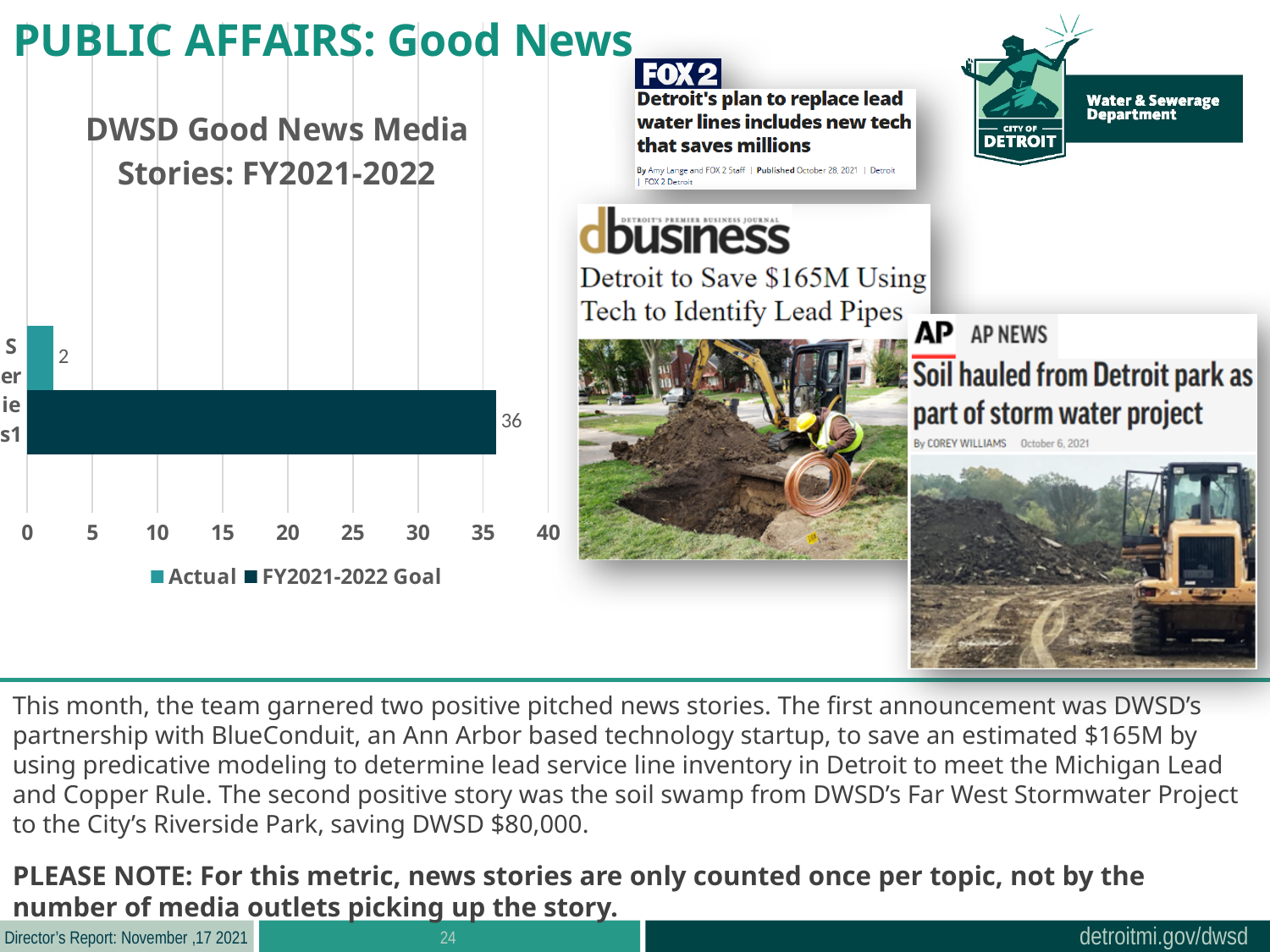
How many series does the legend of the DWSD Good News Media Stories chart list? 2 Which series has the lowest value in the DWSD Good News Media Stories chart? Actual Is the FY2021-2022 Goal value in the chart greater or less than 30? greater What is the title of the chart on the slide? DWSD Good News Media Stories: FY2021-2022 What is the value of the FY2021-2022 Goal bar in the DWSD Good News Media Stories chart? 36 What is the value of the Actual bar in the DWSD Good News Media Stories chart? 2 What kind of chart is used to show the DWSD Good News Media Stories? Bar chart What is the difference between the FY2021-2022 Goal and the Actual value in the chart? 34 Which is larger in the chart, the Actual value or the FY2021-2022 Goal? FY2021-2022 Goal Is the Actual value in the chart greater or less than 5? less What is the highest value shown on the horizontal axis of the chart? 40 Which series has the highest value in the DWSD Good News Media Stories chart? FY2021-2022 Goal